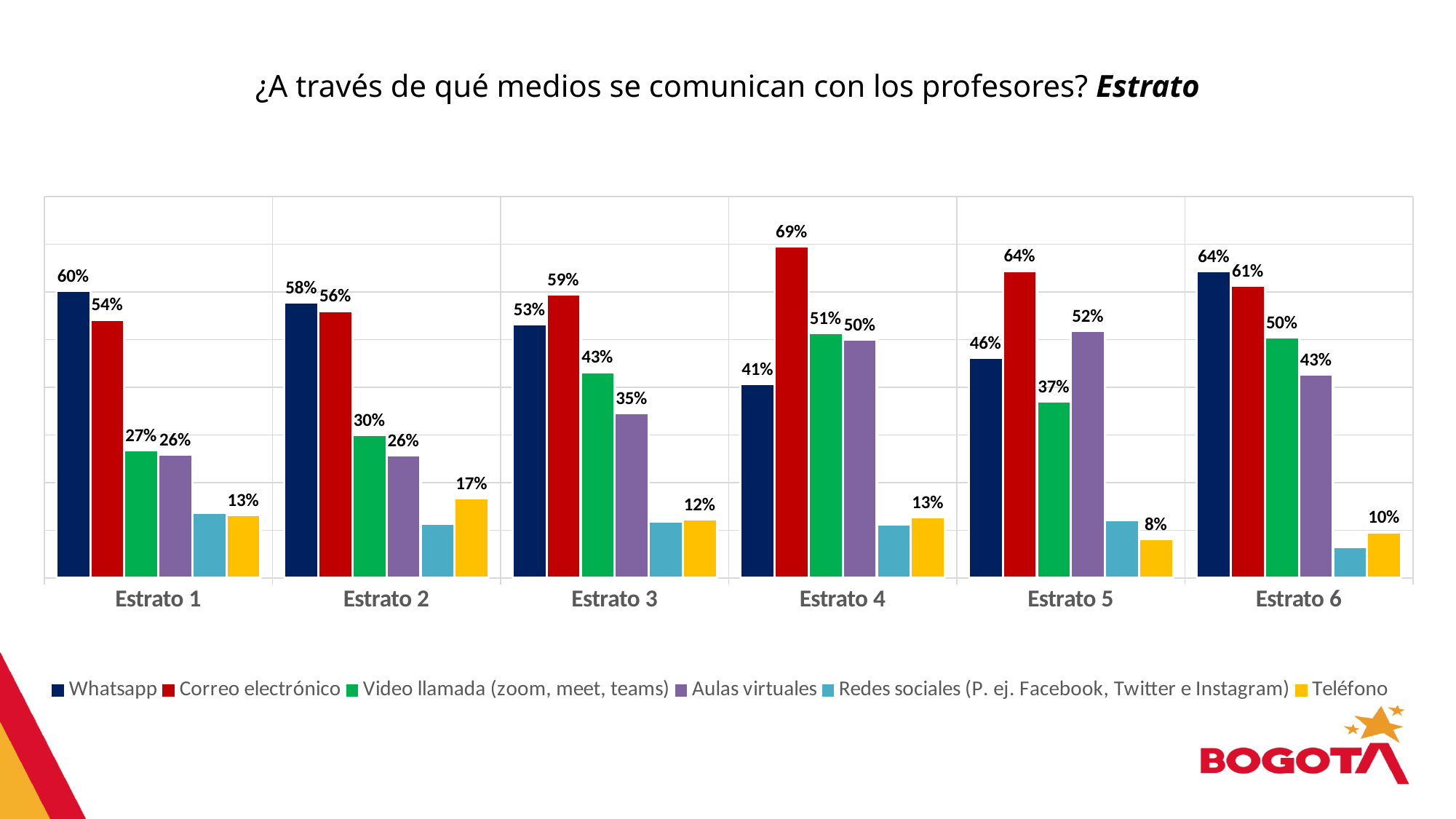
In which estrato is the Teléfono value lowest? Estrato 5 What is the value for Correo electrónico in Estrato 4? 69% What is the difference between the Whatsapp and Correo electrónico values in Estrato 4? 28% What is the value for Teléfono in Estrato 6? 10% What is the value for Aulas virtuales in Estrato 5? 52% Which series is shown in red in the legend? Correo electrónico How many estrato categories are shown on the x axis? 6 In which estrato is the Correo electrónico value highest? Estrato 4 How many series does the legend list? 6 Which is larger in Estrato 3: Video llamada (zoom, meet, teams) or Aulas virtuales? Video llamada (zoom, meet, teams) What is the value for Whatsapp in Estrato 1? 60% What type of chart is shown on the slide? Bar chart